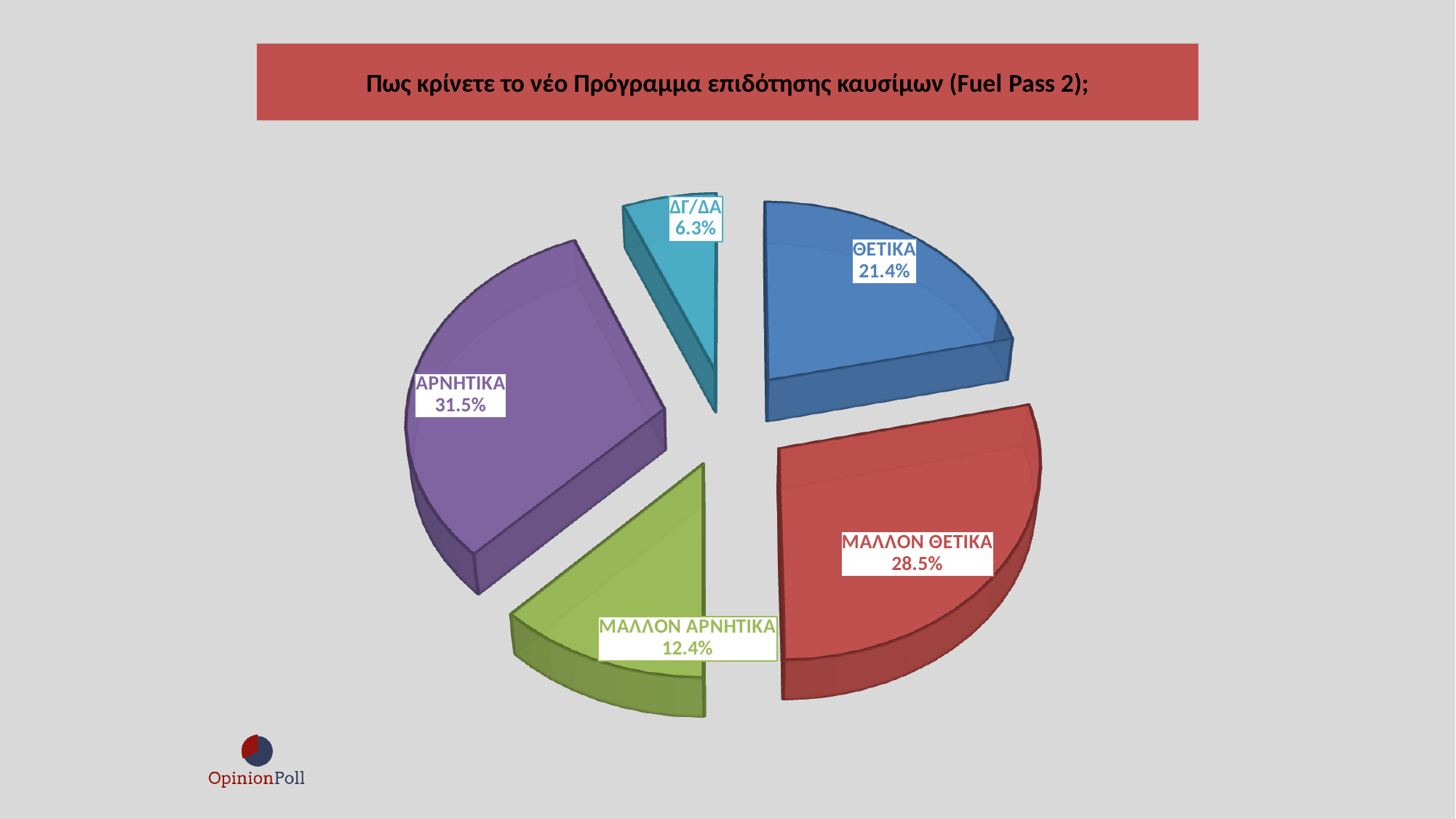
What percentage of respondents answered ΑΡΝΗΤΙΚΑ? 31.5% Which response has the largest share of the pie? ΑΡΝΗΤΙΚΑ What is the difference in percentage points between ΑΡΝΗΤΙΚΑ and ΘΕΤΙΚΑ? 10.1 Which response has the smallest share of the pie? ΔΓ/ΔΑ What percentage of respondents answered ΘΕΤΙΚΑ? 21.4% What percentage of respondents answered ΜΑΛΛΟΝ ΑΡΝΗΤΙΚΑ? 12.4% What kind of chart is shown on the slide? Pie chart What percentage of respondents answered ΔΓ/ΔΑ? 6.3% Which is larger, ΜΑΛΛΟΝ ΘΕΤΙΚΑ or ΜΑΛΛΟΝ ΑΡΝΗΤΙΚΑ? ΜΑΛΛΟΝ ΘΕΤΙΚΑ How many slices does the pie chart have? 5 What colour is the ΑΡΝΗΤΙΚΑ slice? Purple What percentage of respondents answered ΜΑΛΛΟΝ ΘΕΤΙΚΑ? 28.5%